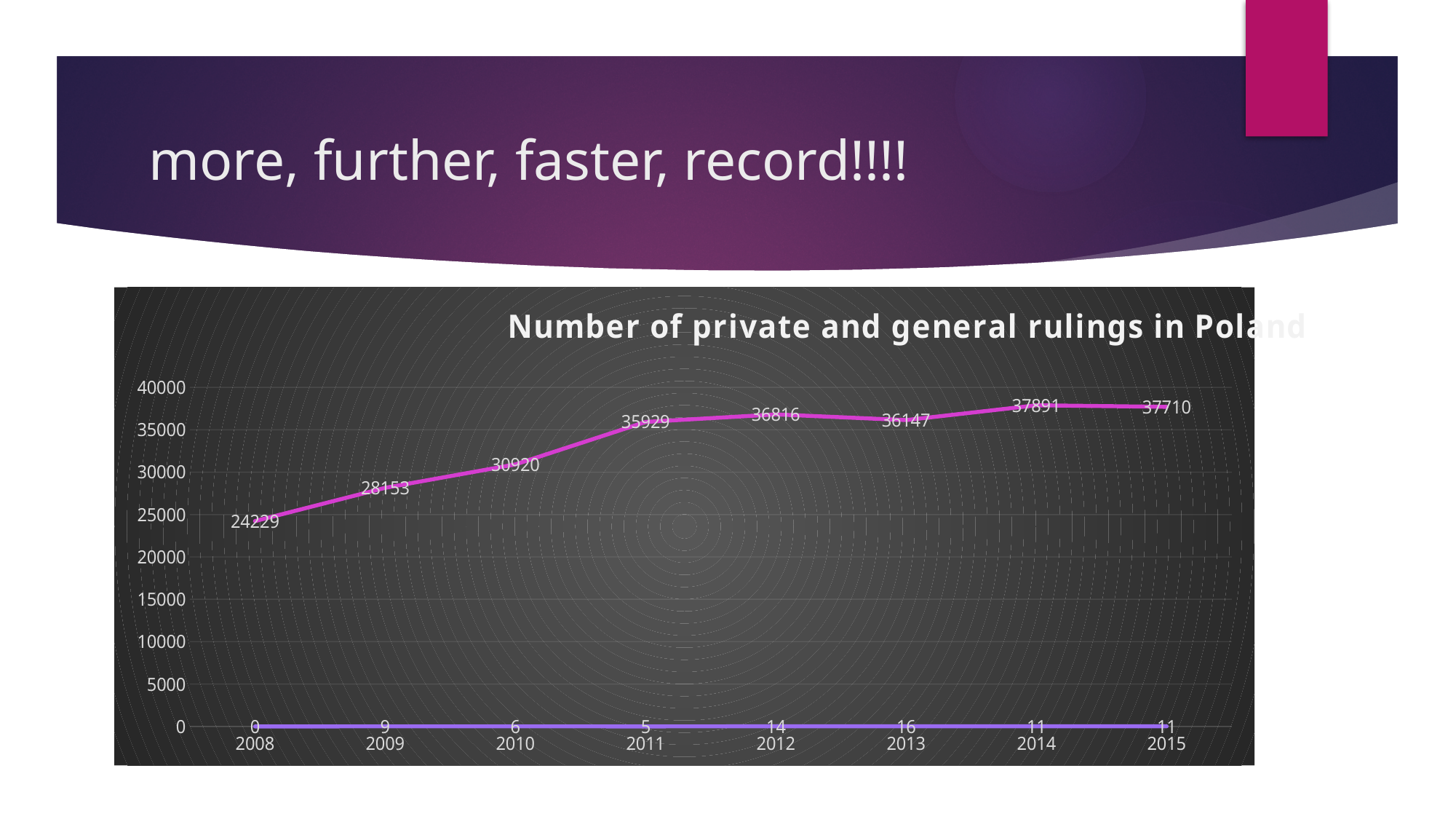
What is the value of the upper (magenta) line in 2015? 37710 What is the title of the chart? Number of private and general rulings in Poland Which is larger for the upper (magenta) line: the value in 2012 or the value in 2013? 2012 What is the value of the upper (magenta) line in 2008? 24229 What is the difference between the upper line's values in 2014 and 2013? 1744 Does the upper (magenta) line generally rise or fall from 2008 to 2011? rise What is the value of the upper (magenta) line in 2011? 35929 In which year does the upper (magenta) line have its lowest value? 2008 In which year does the upper (magenta) line reach its highest value? 2014 What type of chart is shown on the slide? line chart What is the value of the lower (blue) line in 2013? 16 How many years are shown on the x axis of the chart? 8